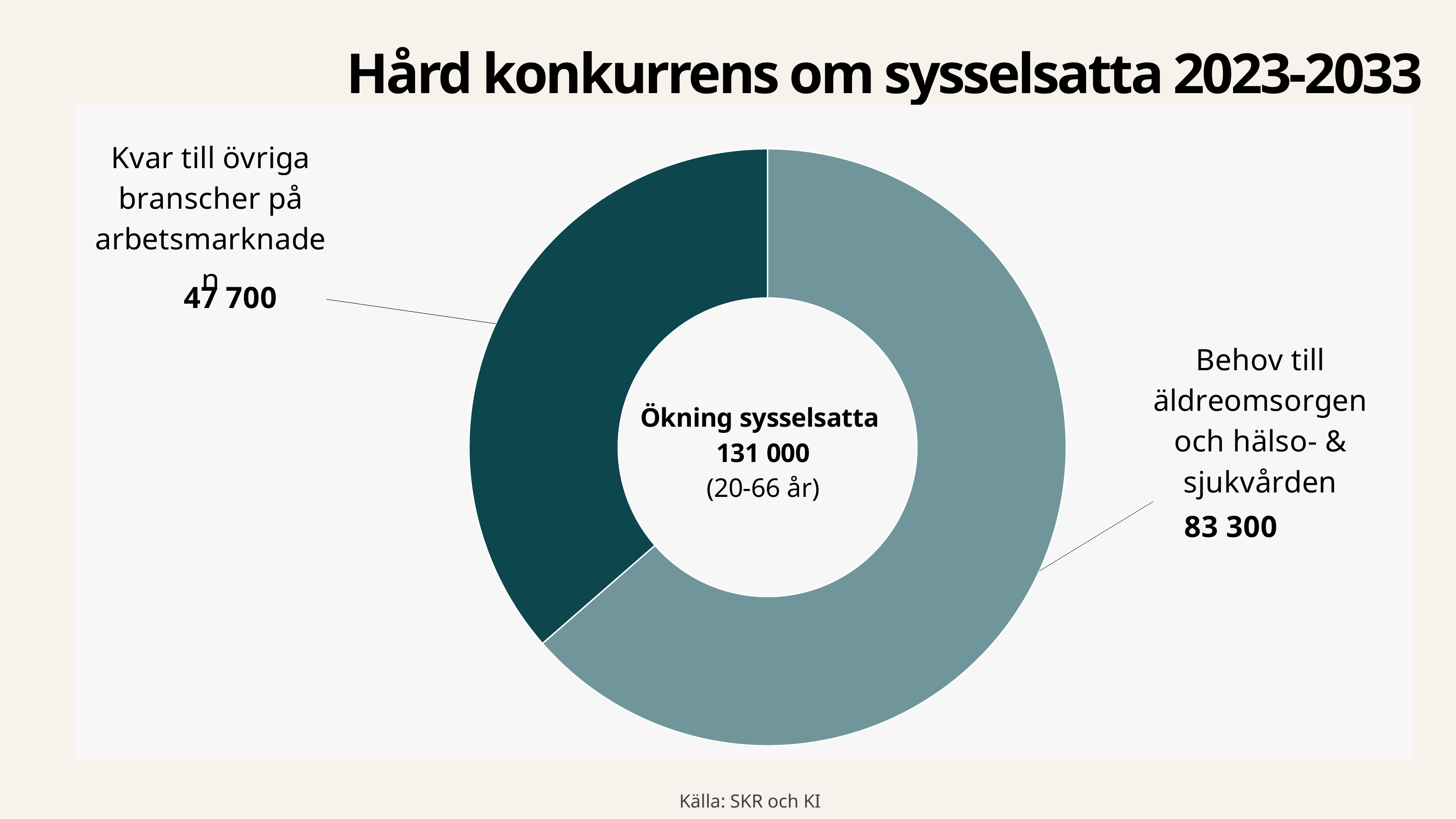
What is the value for "Behov till äldreomsorgen och hälso- & sjukvården"? 83 300 What is the title of the slide? Hård konkurrens om sysselsatta 2023-2033 What is the difference between the value for "Behov till äldreomsorgen och hälso- & sjukvården" and the value for "Kvar till övriga branscher på arbetsmarknaden"? 35 600 Which is larger: the value for "Kvar till övriga branscher på arbetsmarknaden" or the value for "Behov till äldreomsorgen och hälso- & sjukvården"? Behov till äldreomsorgen och hälso- & sjukvården What total increase in employed persons (Ökning sysselsatta) is shown in the centre of the chart? 131 000 Which slice is the largest? Behov till äldreomsorgen och hälso- & sjukvården What age range is given in the centre of the chart? 20-66 år What is the value for "Kvar till övriga branscher på arbetsmarknaden"? 47 700 How many slices does the chart have? 2 What share of the total 131 000 does the slice "Behov till äldreomsorgen och hälso- & sjukvården" (83 300) represent, to the nearest whole percent? 64% What kind of chart is shown on the slide? Doughnut (pie) chart Which slice is the smallest? Kvar till övriga branscher på arbetsmarknaden